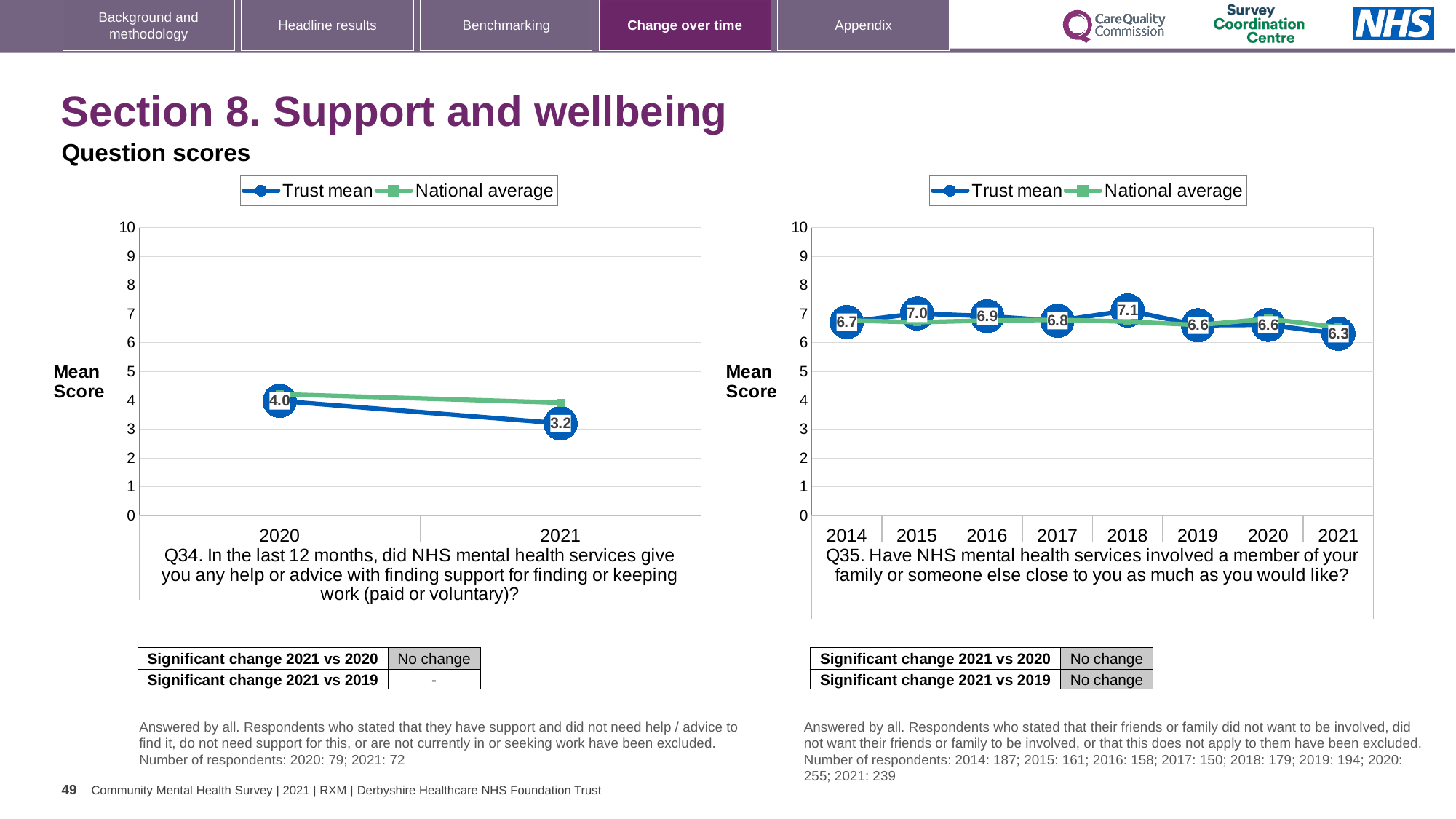
On the right chart (Q35), what is the Trust mean score for 2021? 6.3 On the left chart (Q34), is the National average for 2021 greater or less than 5? less On the left chart (Q34), what is the Trust mean score for 2021? 3.2 On the right chart (Q35), what is the Trust mean score for 2018? 7.1 On the right chart (Q35), which year has the lowest Trust mean score? 2021 On the right chart (Q35), how many years are plotted on the x axis? 8 On the left chart (Q34), what is the Trust mean score for 2020? 4.0 On the left chart (Q34), does the Trust mean rise or fall from 2020 to 2021? fall On the right chart (Q35), which year has the highest Trust mean score? 2018 On the right chart (Q35), what is the difference between the Trust mean scores for 2015 and 2014? 0.3 On the left chart (Q34), what is the difference between the Trust mean scores for 2020 and 2021? 0.8 How many series does the legend of the left chart list? 2